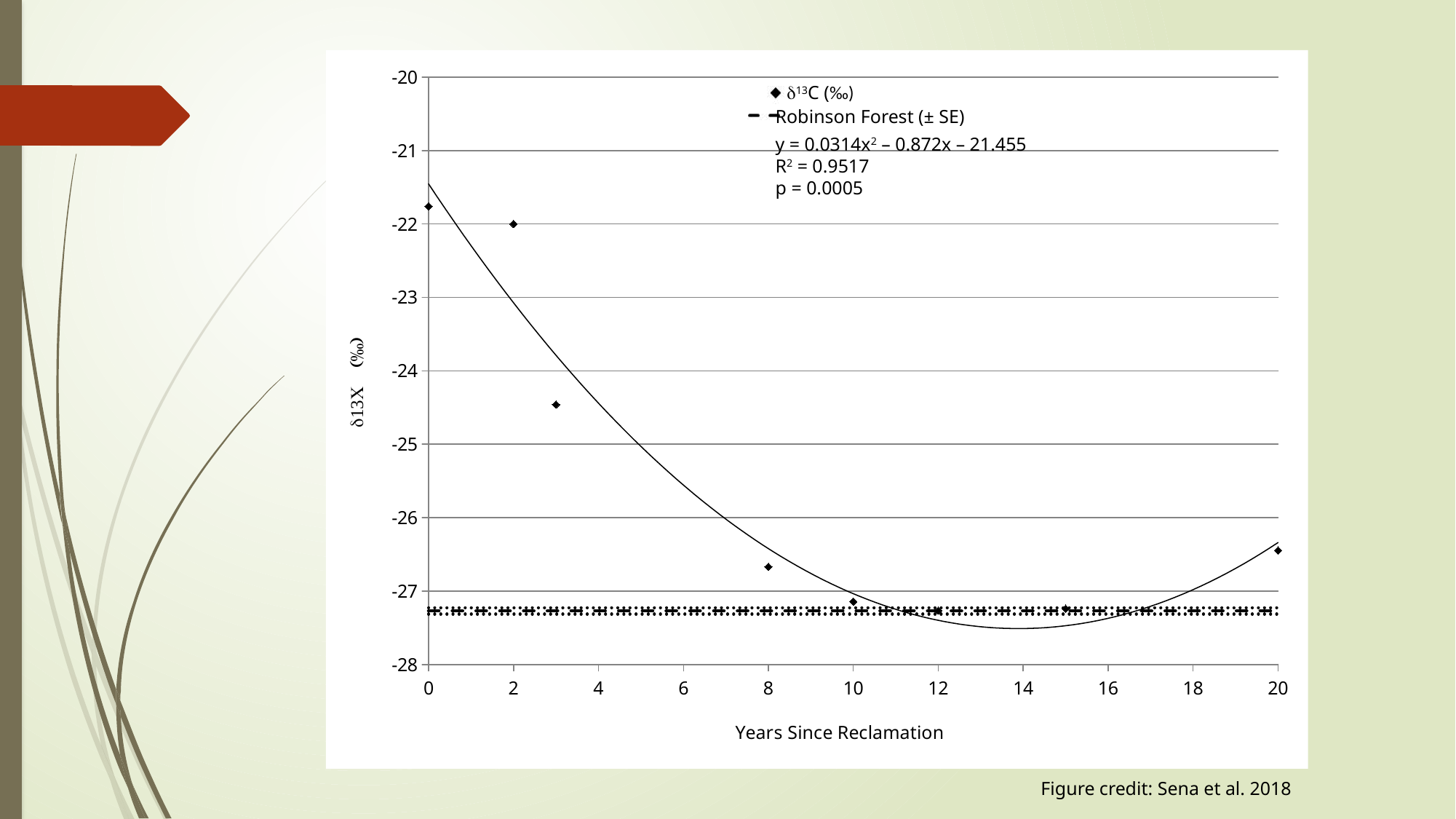
Which has the higher δ13C value: the point at 3 years or the point at 8 years? 3 years Is the δ13C value at 8 years since reclamation greater or less than -26? less At which number of years since reclamation is the δ13C value highest? 0 How many entries does the legend list? 2 Is the δ13C value at 3 years since reclamation greater or less than -24? less What R² value is shown for the fitted curve? 0.9517 What kind of chart is shown on the slide? scatter chart Is the Robinson Forest reference line greater or less than -27? less How many data points are plotted for δ13C (‰)? 8 Do the δ13C values rise or fall between 0 and 10 years since reclamation? fall What is the x-axis title of the chart? Years Since Reclamation